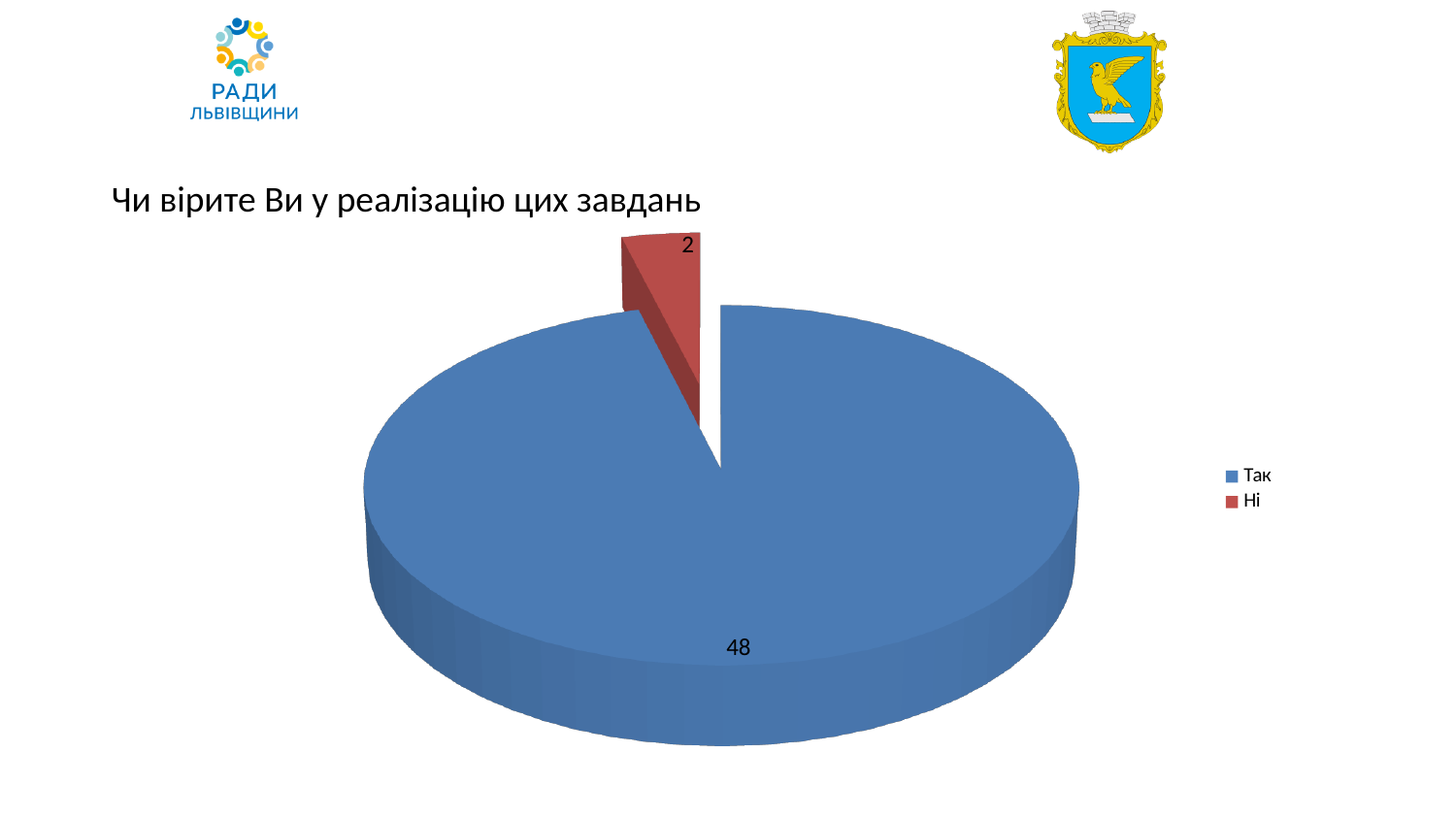
What share of the pie does "Так" represent? 96% What colour is the "Ні" slice? red Which is larger, the value for "Так" or the value for "Ні"? Так Which category has the largest slice? Так How many categories does the pie chart have? 2 What kind of chart is shown on the slide? pie chart What is the difference between the values for "Так" and "Ні"? 46 What is the value for "Так"? 48 Which category has the smallest slice? Ні What share of the pie does "Ні" represent? 4% What is the total of all slices in the pie chart? 50 What is the value for "Ні"? 2